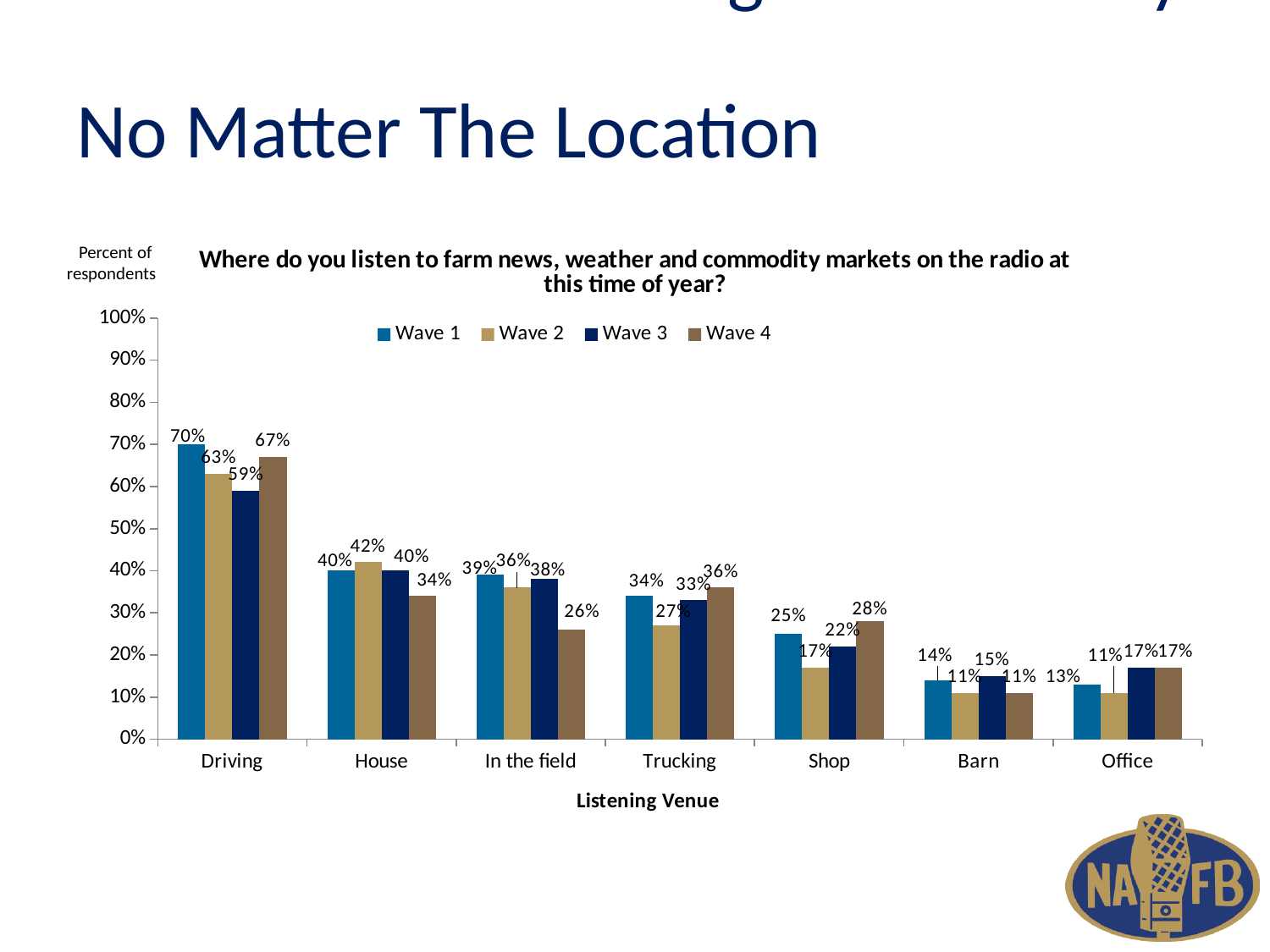
How many series does the legend list? 4 Which listening venue has the lowest Wave 1 value? Office What is the difference between the Wave 1 and Wave 3 values for Driving? 11% Which listening venue has the highest Wave 4 value? Driving What is the title of the chart? Where do you listen to farm news, weather and commodity markets on the radio at this time of year? Is the Wave 3 value for House greater or less than 30%? greater What type of chart is shown on the slide? bar chart What is the Wave 1 value for Driving? 70% For Trucking, which is larger: the Wave 2 value or the Wave 4 value? Wave 4 How many listening venues are shown on the x axis? 7 What is the Wave 4 value for In the field? 26% What is the Wave 2 value for Shop? 17%